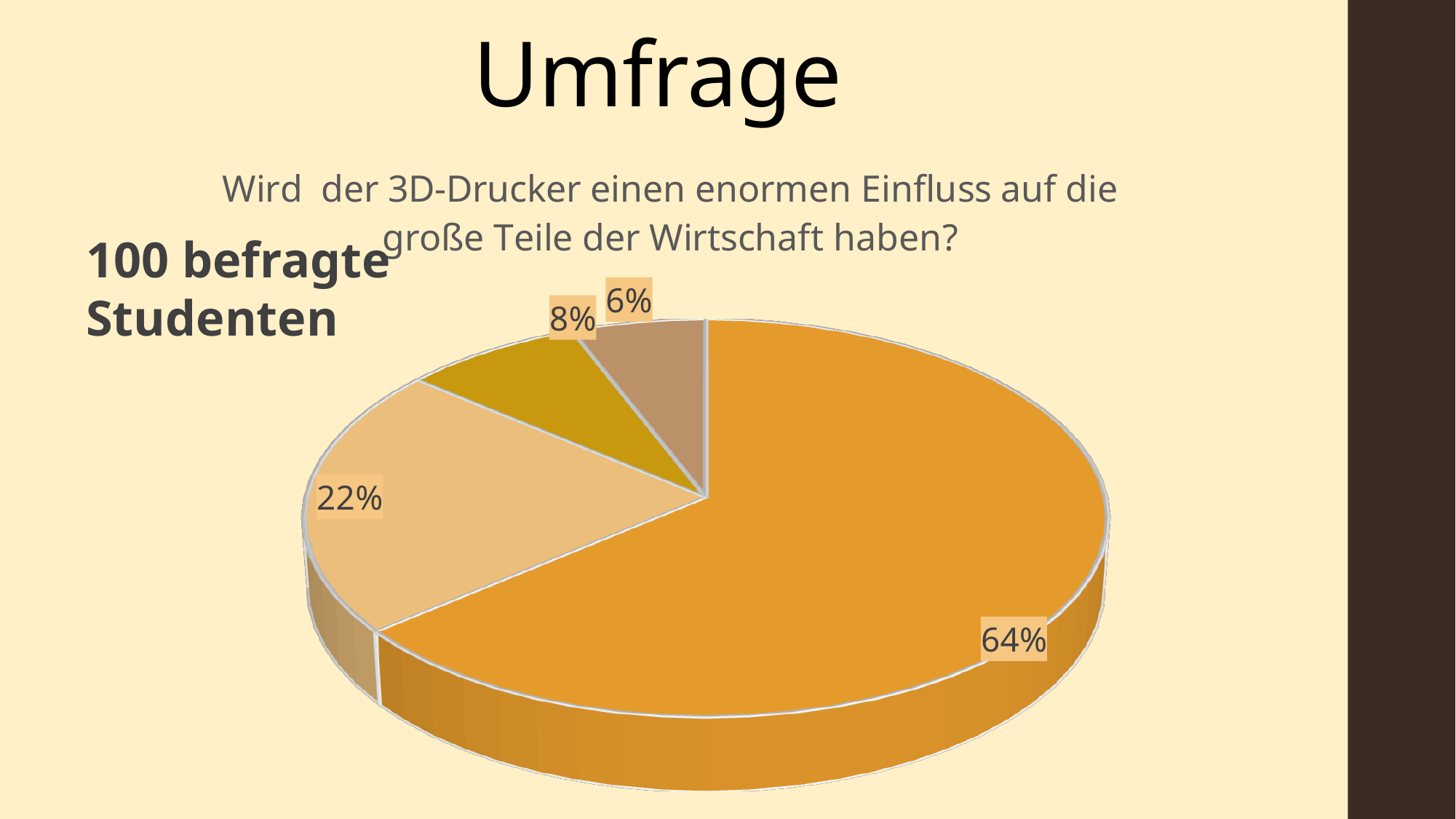
What is the difference between the largest slice (64%) and the second-largest slice (22%)? 42% What question is shown as the title above the pie chart? Wird der 3D-Drucker einen enormen Einfluss auf die große Teile der Wirtschaft haben? What is the difference between the 8% slice and the 6% slice? 2% How many students were surveyed according to the text on the slide? 100 What kind of chart is shown on the slide? pie chart What is the share of the largest slice of the pie chart? 64% Which is larger, the 22% slice or the 8% slice? the 22% slice What is the combined share of the two smallest slices (8% and 6%)? 14% What share is shown for the light tan slice on the left of the pie chart? 22% How many slices does the pie chart have? 4 What is the share of the smallest slice of the pie chart? 6% What share is shown for the dark gold slice of the pie chart? 8%